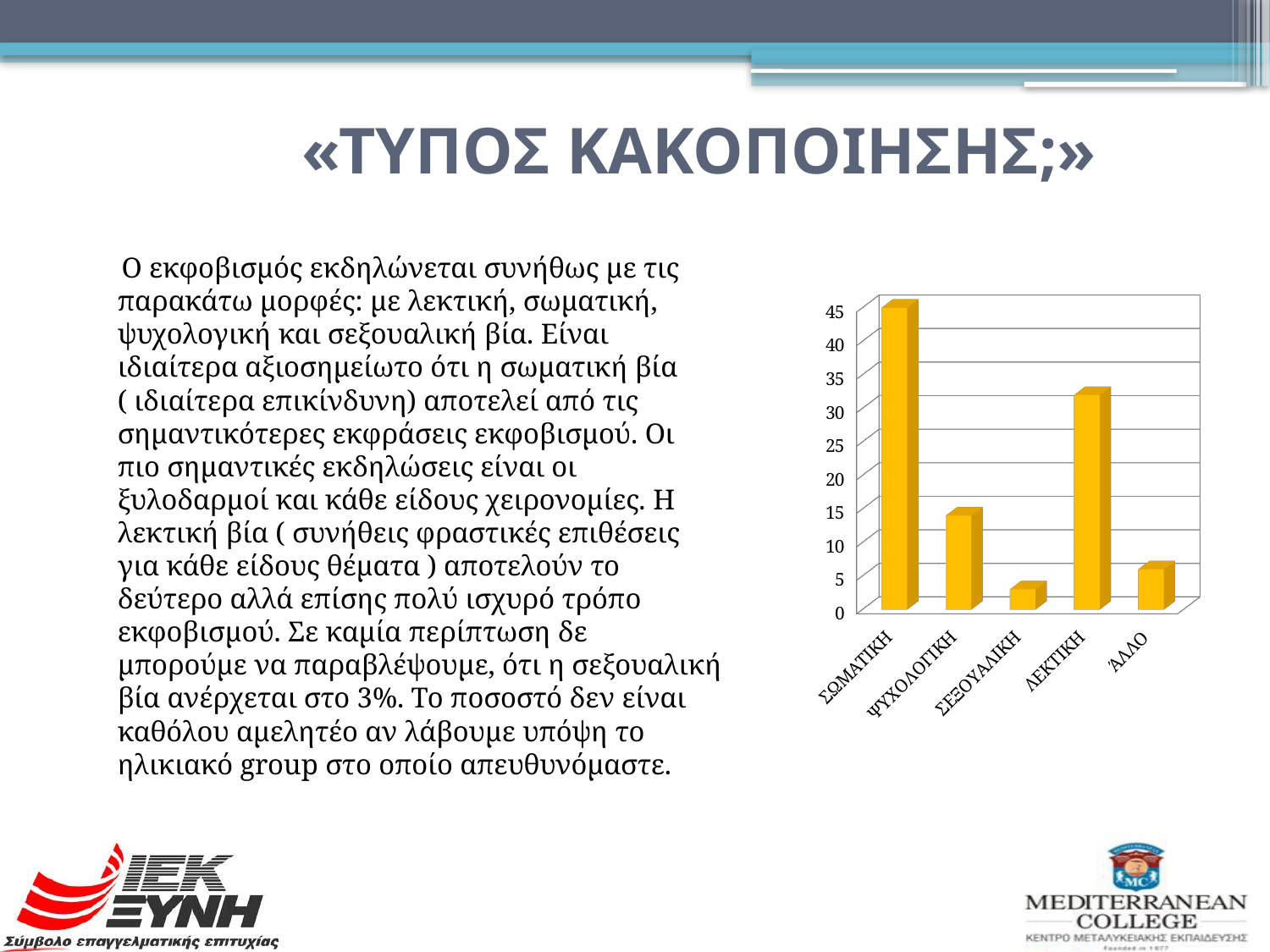
Which is larger in the chart, ΆΛΛΟ or ΣΕΞΟΥΑΛΙΚΗ? ΆΛΛΟ What kind of chart is shown on the slide? bar chart Which category has the highest bar in the chart? ΣΩΜΑΤΙΚΗ Is the value for ΣΩΜΑΤΙΚΗ greater or less than 40? greater Which is larger in the chart, ΛΕΚΤΙΚΗ or ΨΥΧΟΛΟΓΙΚΗ? ΛΕΚΤΙΚΗ Is the value for ΨΥΧΟΛΟΓΙΚΗ greater or less than 20? less Is the value for ΆΛΛΟ greater or less than 10? less How many categories are shown on the x axis of the chart? 5 Which category has the lowest bar in the chart? ΣΕΞΟΥΑΛΙΚΗ What is the highest tick value shown on the vertical axis of the chart? 45